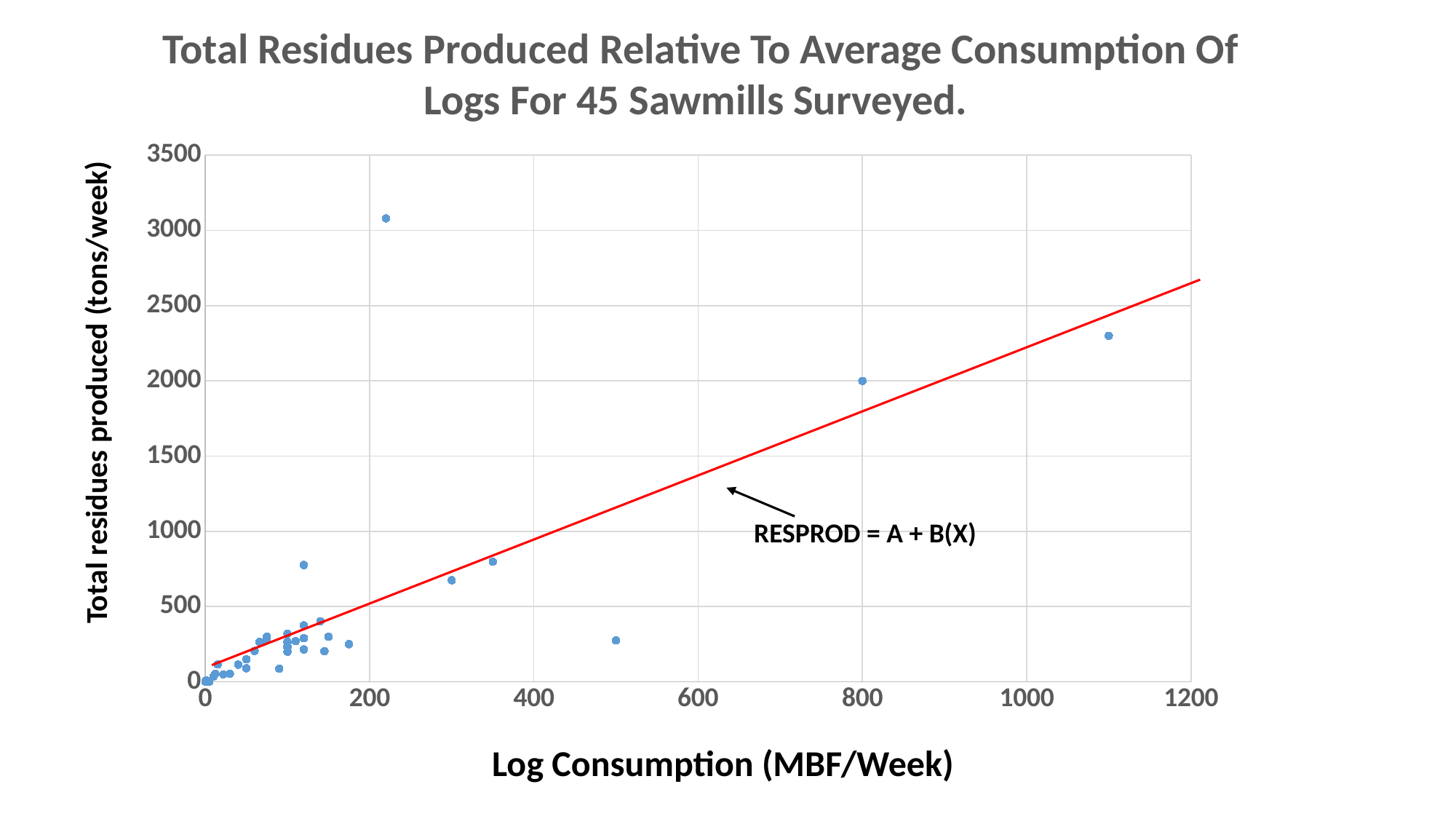
Is the value for the highest point on the chart (near 220 MBF/week) greater or less than 3000 tons/week? greater Is the value for the point at about 300 MBF/week of log consumption greater or less than 500 tons/week? greater Is the value for the point at about 1100 MBF/week of log consumption greater or less than 2000 tons/week? greater What is the title of the chart? Total Residues Produced Relative To Average Consumption Of Logs For 45 Sawmills Surveyed. What is the maximum value shown on the y axis? 3500 What kind of chart is shown on the slide? Scatter chart Which point has higher total residues produced: the one at about 800 MBF/week or the one at about 500 MBF/week? The one at about 800 MBF/week Do total residues produced generally rise or fall as log consumption increases along the x axis? Rise What equation is written in the annotation pointing to the red line? RESPROD = A + B(X) According to the chart title, how many sawmills were surveyed? 45